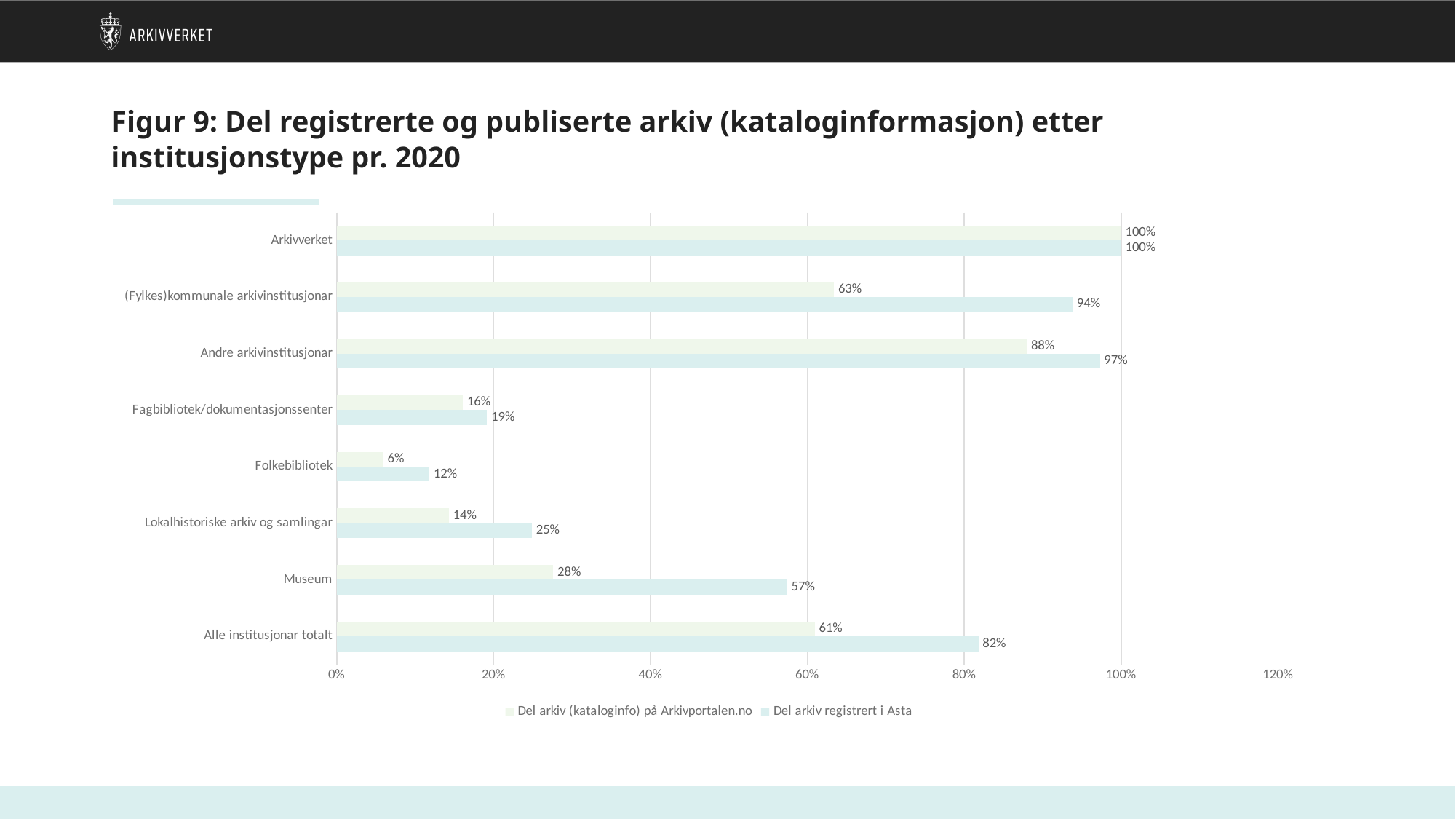
How many series does the legend list? 2 What is the value for Folkebibliotek in the 'Del arkiv (kataloginfo) på Arkivportalen.no' series? 6% Is the 'Del arkiv registrert i Asta' value for Andre arkivinstitusjonar greater or less than 80%? greater Which is larger for Lokalhistoriske arkiv og samlingar: the Arkivportalen.no value or the Asta value? Del arkiv registrert i Asta What is the 'Del arkiv registrert i Asta' value for Alle institusjonar totalt? 82% What is the value for Museum in the 'Del arkiv registrert i Asta' series? 57% How many categories are shown on the chart? 8 Which category has the highest value in the 'Del arkiv (kataloginfo) på Arkivportalen.no' series? Arkivverket What is the difference between the two series' values for (Fylkes)kommunale arkivinstitusjonar? 31% Which category has the lowest value in the 'Del arkiv registrert i Asta' series? Folkebibliotek What kind of chart is shown on the slide? Bar chart What is the title of the chart on the slide? Figur 9: Del registrerte og publiserte arkiv (kataloginformasjon) etter institusjonstype pr. 2020